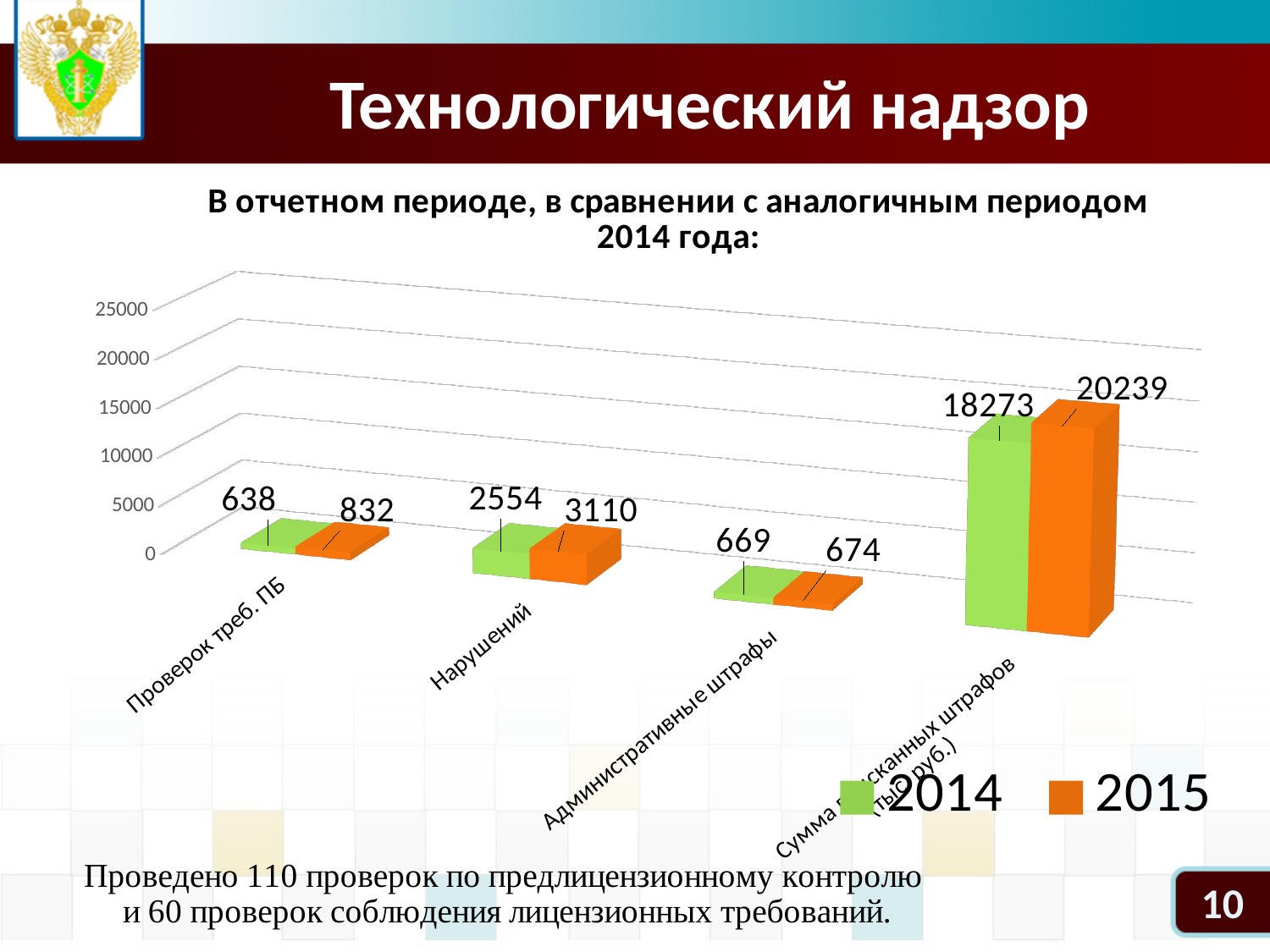
What is the 2015 value for Административные штрафы? 674 Which category has the lowest 2014 value? Проверок треб. ПБ How many series does the legend list? 2 For Административные штрафы, which year has the larger value, 2014 or 2015? 2015 What is the difference between the 2015 and 2014 values for Проверок треб. ПБ? 194 What is the 2014 value for the rightmost category (sum of collected fines, тыс. руб.)? 18273 What is the 2014 value for Проверок треб. ПБ? 638 What is the difference between the 2015 and 2014 values for the rightmost category? 1966 What kind of chart is shown on the slide? Bar chart What is the 2015 value for Нарушений? 3110 How many categories are shown on the x axis of the chart? 4 By how much does the 2015 value for Нарушений exceed the 2014 value? 556